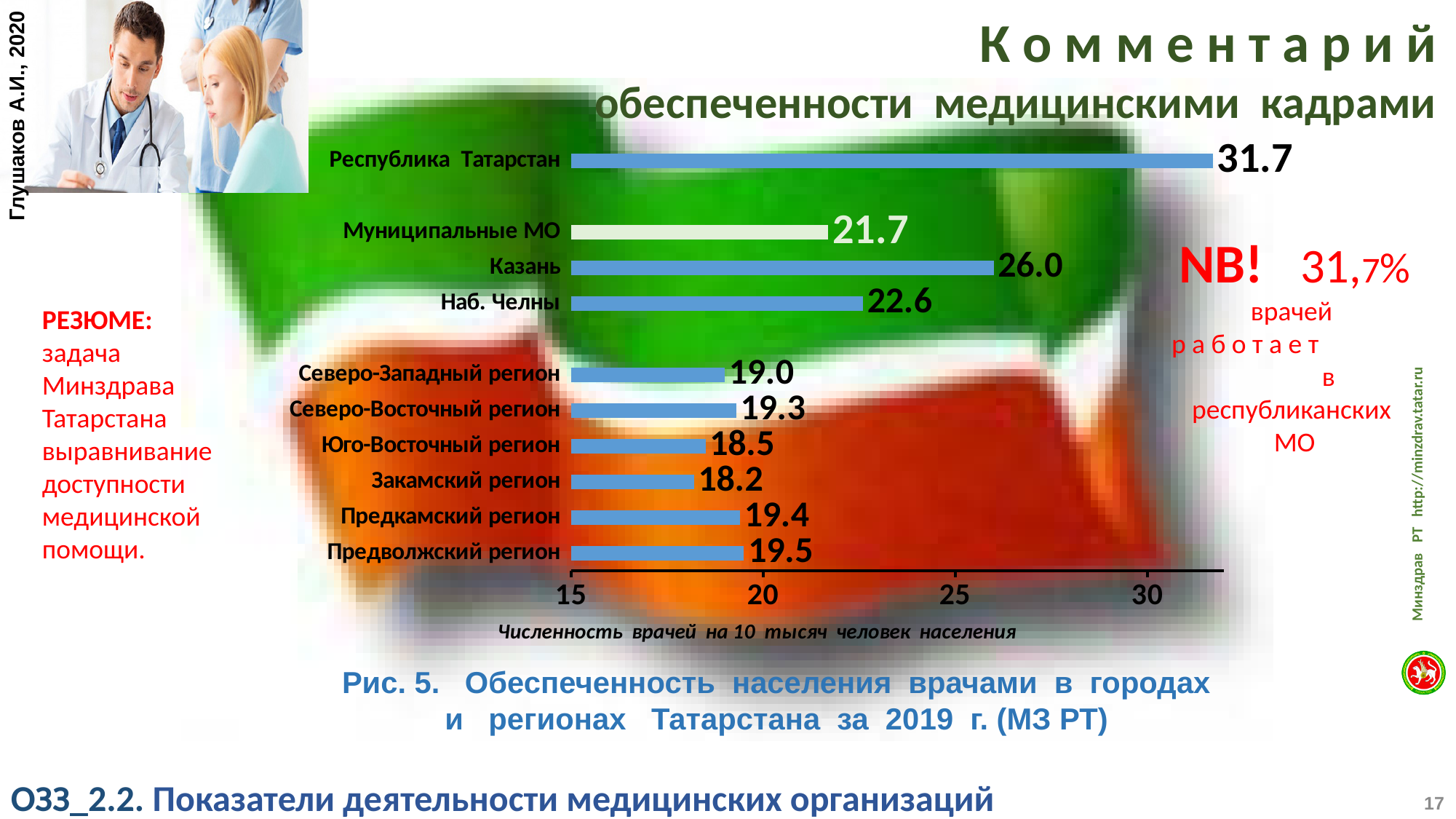
What is the value for Муниципальные МО? 21.7 What is the label of the horizontal axis of the chart? Численность врачей на 10 тысяч человек населения Which category has the highest value? Республика Татарстан What is the difference between the values for Казань and Наб. Челны? 3.4 What is the value for Закамский регион? 18.2 What kind of chart is shown on the slide? bar chart Is the value for Северо-Восточный регион greater or less than 20? less Which category has the lowest value? Закамский регион Which is larger, the value for Предкамский регион or the value for Юго-Восточный регион? Предкамский регион What is the value for Казань? 26.0 What is the value for Республика Татарстан? 31.7 How many categories are shown in the chart? 10